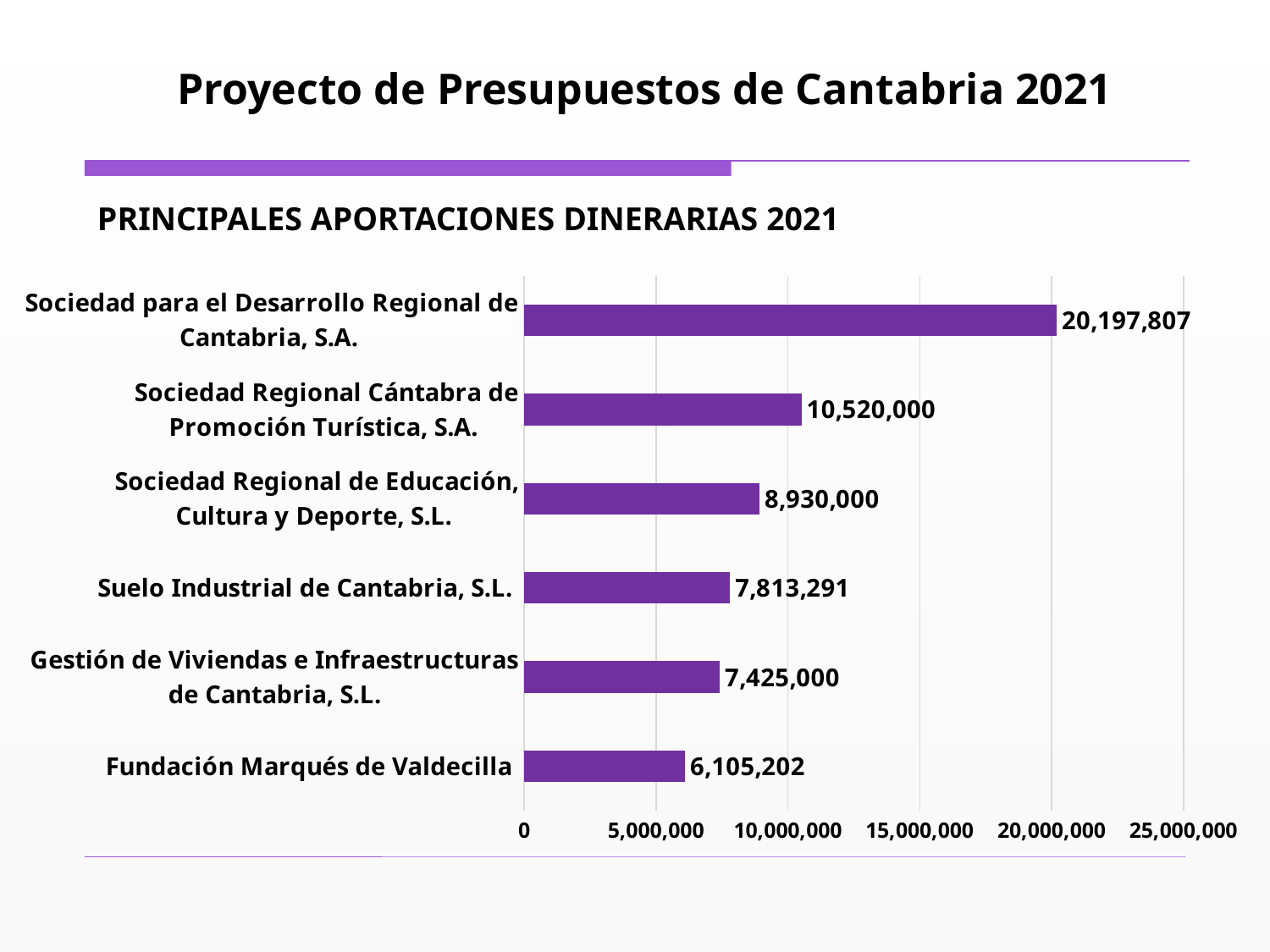
What is the value for Fundación Marqués de Valdecilla? 6,105,202 Which category has the lowest value? Fundación Marqués de Valdecilla Which is larger: the value for Sociedad Regional de Educación, Cultura y Deporte, S.L. or the value for Suelo Industrial de Cantabria, S.L.? Sociedad Regional de Educación, Cultura y Deporte, S.L. What is the value for Sociedad para el Desarrollo Regional de Cantabria, S.A.? 20,197,807 What is the difference between the values for Suelo Industrial de Cantabria, S.L. and Gestión de Viviendas e Infraestructuras de Cantabria, S.L.? 388,291 Which category has the highest value? Sociedad para el Desarrollo Regional de Cantabria, S.A. What is the value for Sociedad Regional Cántabra de Promoción Turística, S.A.? 10,520,000 Is the value for Suelo Industrial de Cantabria, S.L. greater or less than 5,000,000? greater What is the value for Gestión de Viviendas e Infraestructuras de Cantabria, S.L.? 7,425,000 How many categories are shown in the chart? 6 What is the difference between the values for Sociedad para el Desarrollo Regional de Cantabria, S.A. and Sociedad Regional Cántabra de Promoción Turística, S.A.? 9,677,807 What kind of chart is shown on the slide? bar chart